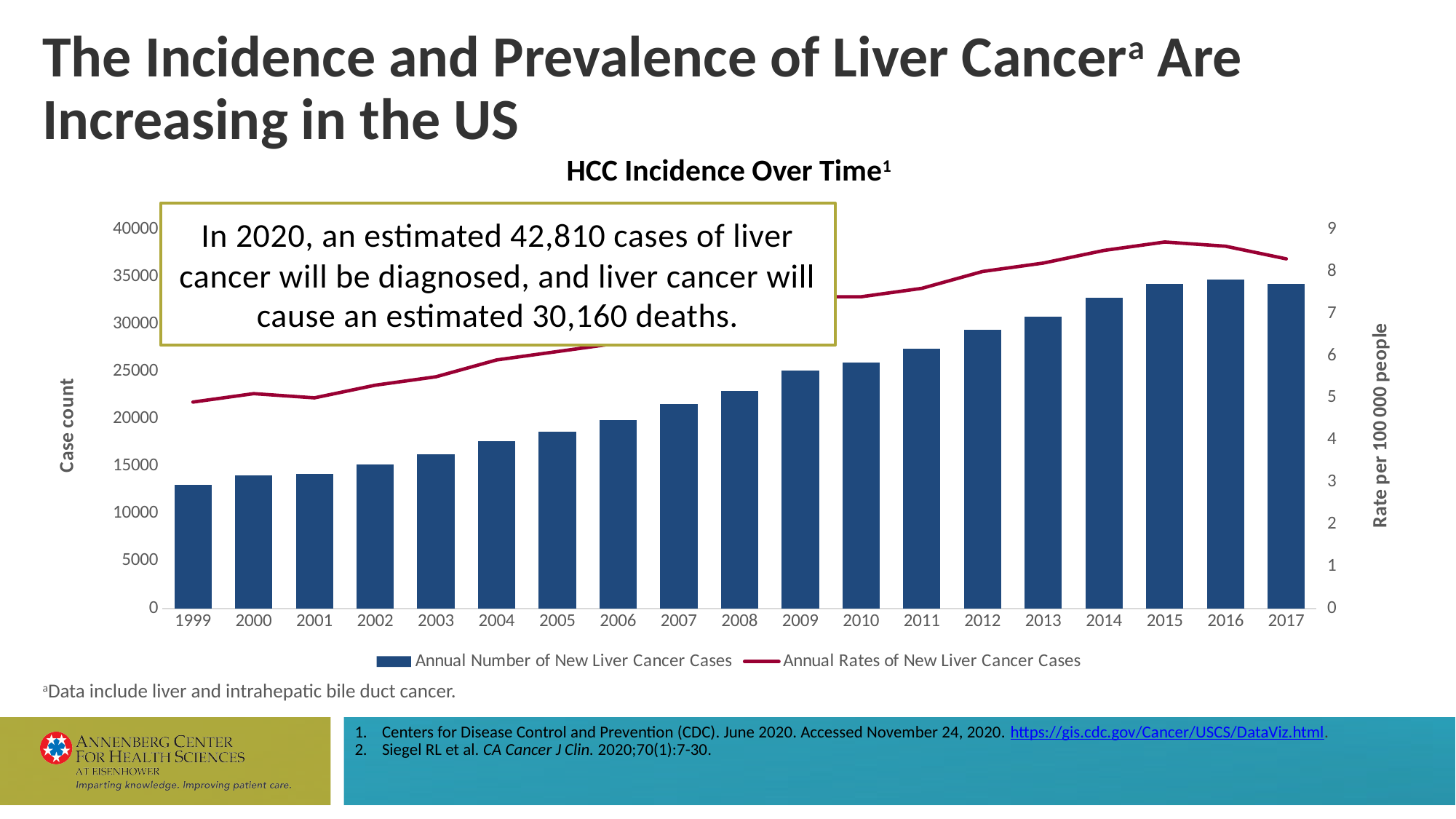
Is the annual number of new liver cancer cases in 1999 greater or less than 15000? less Which year has the highest annual number of new liver cancer cases? 2016 Is the annual number of new liver cancer cases in 2005 greater or less than 20000? less How many series does the chart legend list? 2 What is the title of the chart? HCC Incidence Over Time Overall, do the annual number of new liver cancer cases rise or fall from 1999 to 2017? rise In which year does the annual rate of new liver cancer cases peak? 2015 How many years are shown on the x axis of the chart? 19 What is the label of the right-hand vertical axis? Rate per 100 000 people Is the annual rate of new liver cancer cases in 2015 greater or less than 8 per 100 000 people? greater Which year has the lowest annual number of new liver cancer cases? 1999